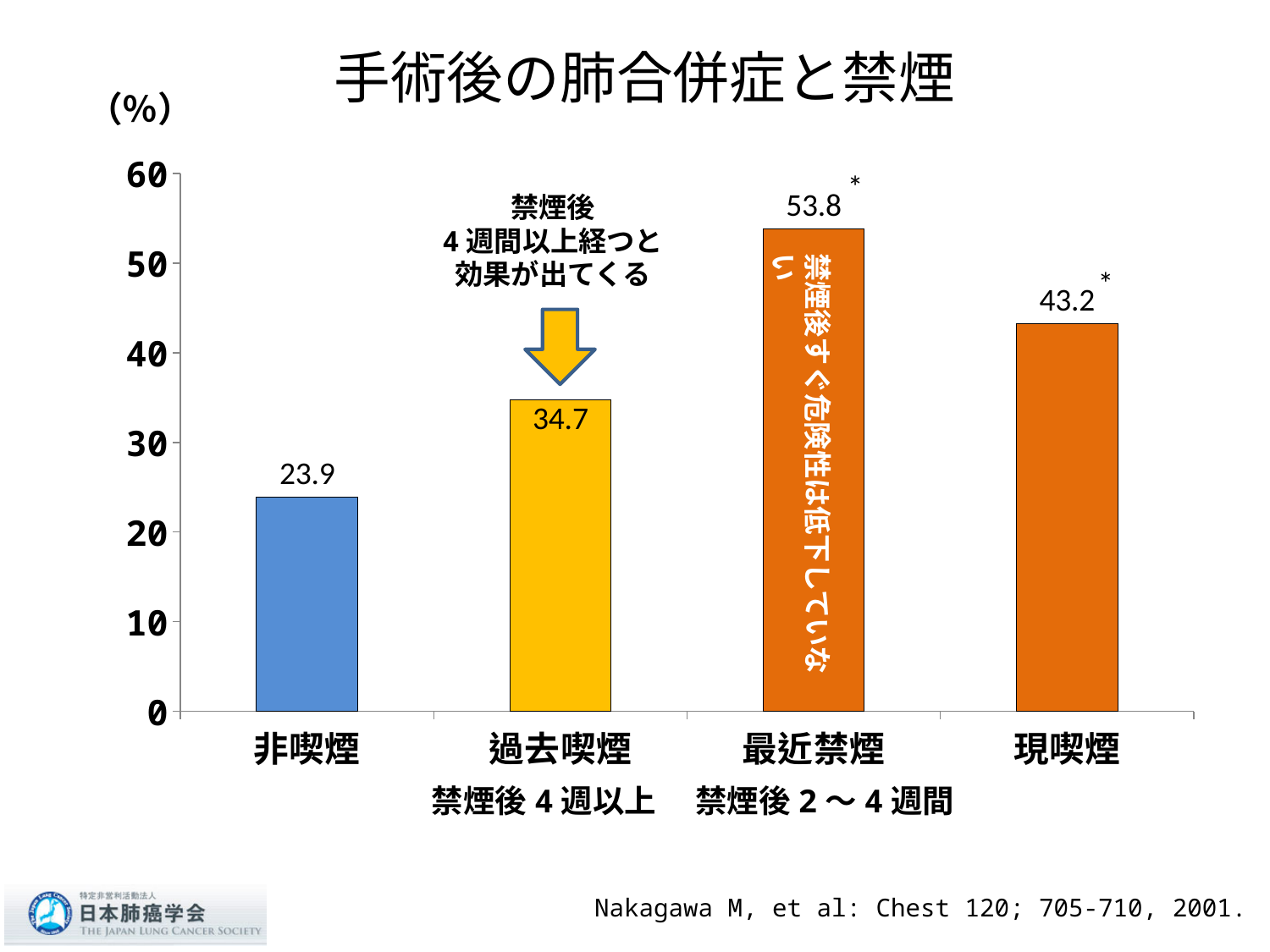
What is the value for 現喫煙? 43.2 Which category has the highest value? 最近禁煙 Which is larger, the value for 現喫煙 or the value for 過去喫煙? 現喫煙 What is the difference between the values for 現喫煙 and 過去喫煙? 8.5 What is the value for 最近禁煙? 53.8 Which category has the lowest value? 非喫煙 What is the difference between the values for 最近禁煙 and 非喫煙? 29.9 What kind of chart is shown on the slide? bar chart What is the value for 非喫煙? 23.9 How many categories are shown on the chart? 4 Is the value for 最近禁煙 greater or less than 50? greater What is the value for 過去喫煙? 34.7